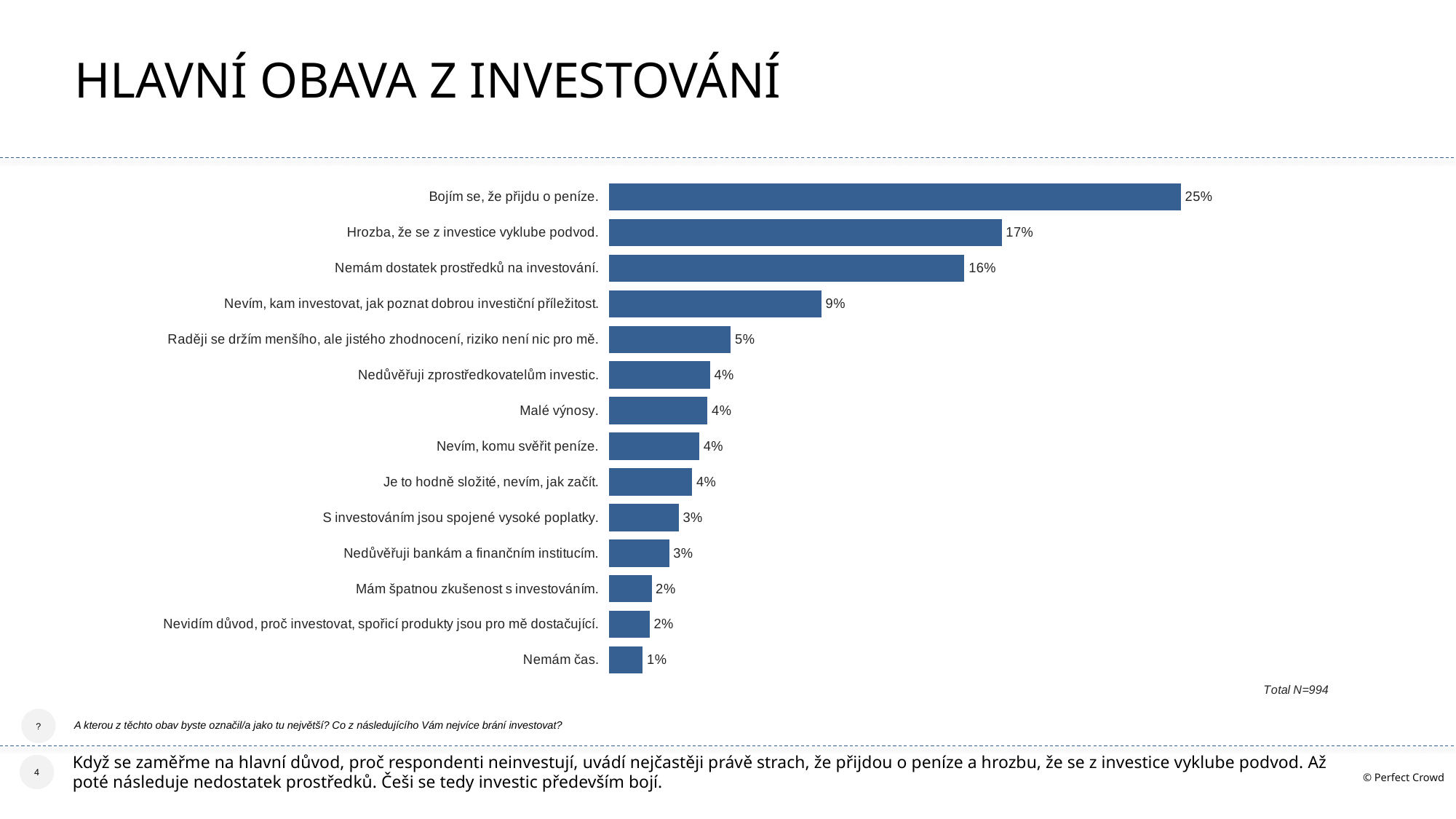
What is the total sample size (N) noted on the slide? Total N=994 What is the difference between the values for "Hrozba, že se z investice vyklube podvod." and "Nevím, kam investovat, jak poznat dobrou investiční příležitost."? 8% How many categories are shown in the chart? 14 What kind of chart is shown on the slide? Bar chart Which is larger: the value for "Raději se držím menšího, ale jistého zhodnocení, riziko není nic pro mě." or the value for "S investováním jsou spojené vysoké poplatky."? Raději se držím menšího, ale jistého zhodnocení, riziko není nic pro mě. Which category has the lowest value? Nemám čas. What value is shown for "Nemám dostatek prostředků na investování."? 16% What value is shown for "Nevím, kam investovat, jak poznat dobrou investiční příležitost."? 9% What value is shown for "Bojím se, že přijdu o peníze."? 25% What value is shown for "Mám špatnou zkušenost s investováním."? 2% What is the difference between the values for "Bojím se, že přijdu o peníze." and "Hrozba, že se z investice vyklube podvod."? 8% Which category has the highest value? Bojím se, že přijdu o peníze.